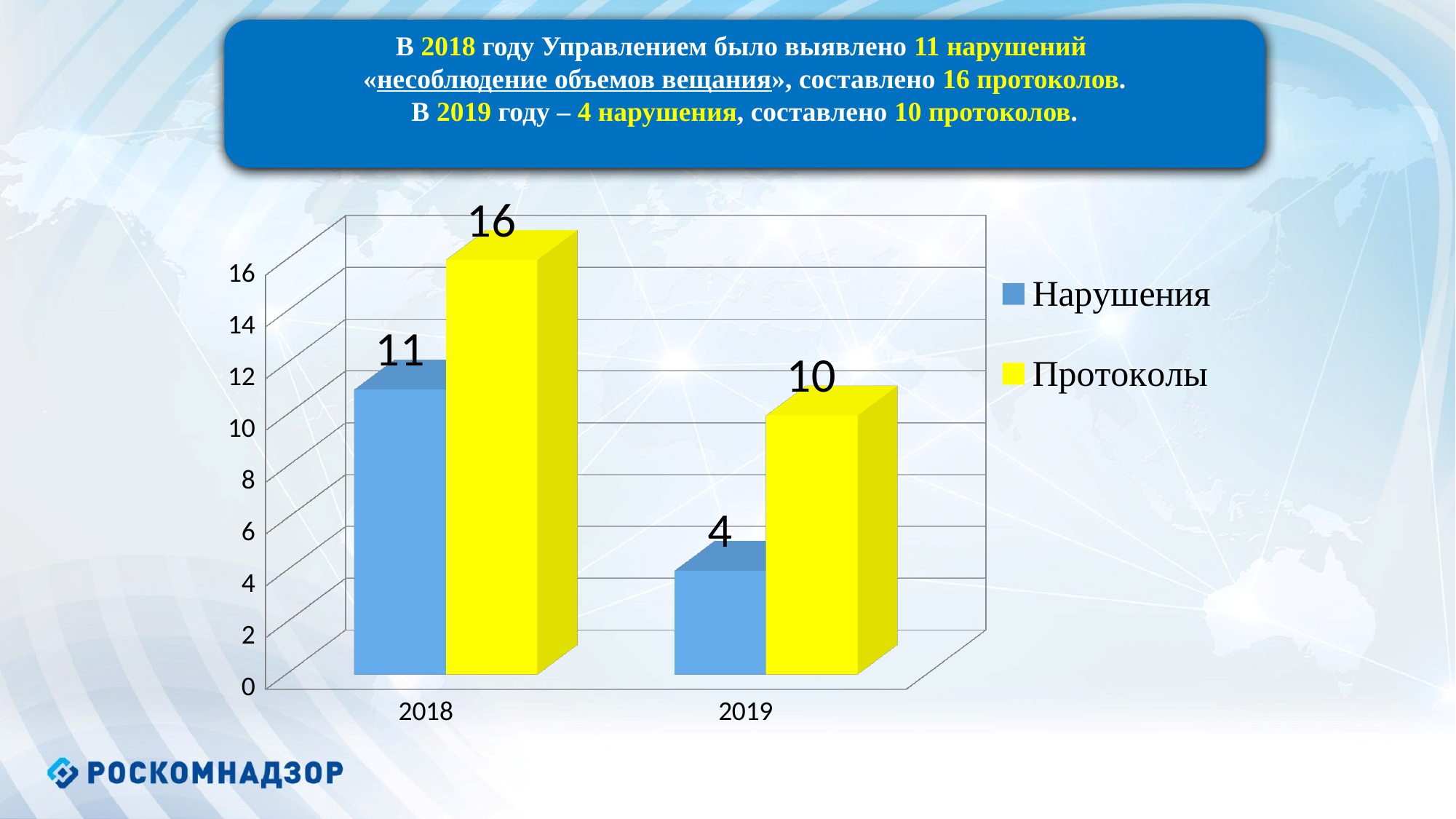
Which year has the highest value for Протоколы? 2018 What is the value of Протоколы for 2019? 10 What kind of chart is shown on the slide? Bar chart Which year has the lowest value for Нарушения? 2019 What is the value of Протоколы for 2018? 16 What is the value of Нарушения for 2018? 11 Which is larger in 2018: Нарушения or Протоколы? Протоколы How many series does the legend list? 2 What is the difference between Нарушения and Протоколы in 2019? 6 What is the value of Нарушения for 2019? 4 What is the difference between Протоколы in 2018 and Протоколы in 2019? 6 How many years are shown on the x axis? 2